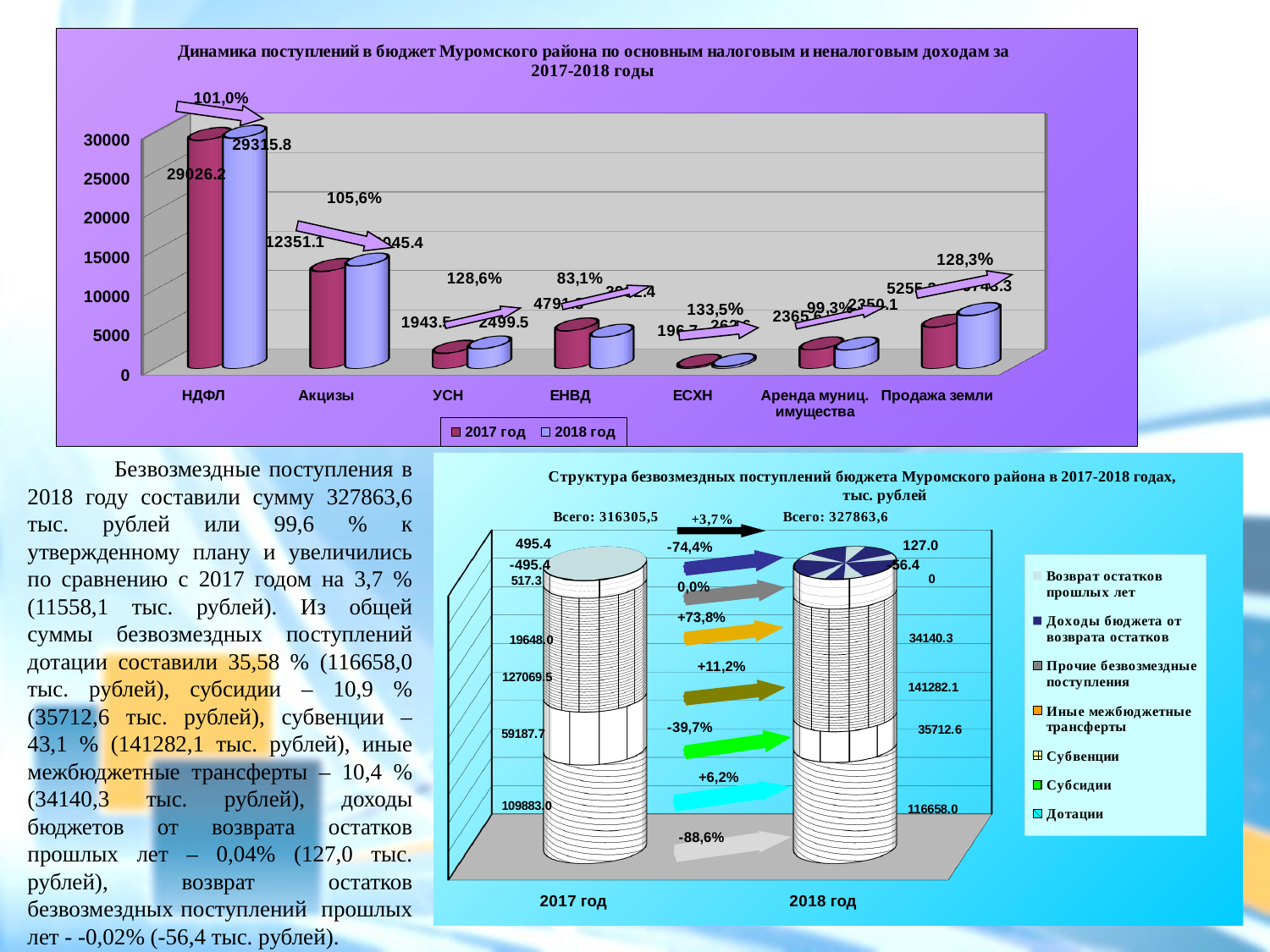
In the top chart (Динамика поступлений в бюджет Муромского района), by how much did НДФЛ increase from 2017 год to 2018 год? 289.6 In the bottom chart (Структура безвозмездных поступлений), what is the value for Дотации in 2018 год? 116658.0 In the top chart (Динамика поступлений в бюджет Муромского района), what is the value for УСН in 2018 год? 2499.5 In the top chart (Динамика поступлений в бюджет Муромского района), is the 2017 год value for Акцизы greater or less than 10000? greater In the bottom chart (Структура безвозмездных поступлений), how many entries does the legend list? 7 In the top chart (Динамика поступлений в бюджет Муромского района), what is the value for НДФЛ in 2017 год? 29026.2 In the top chart (Динамика поступлений в бюджет Муромского района), what is the value for НДФЛ in 2018 год? 29315.8 In the top chart (Динамика поступлений в бюджет Муромского района), how many categories are shown on the x axis? 7 In the bottom chart (Структура безвозмездных поступлений), what is the total (Всего) for 2018 год? 327863,6 In the top chart (Динамика поступлений в бюджет Муромского района), how many series does the legend list? 2 In the top chart (Динамика поступлений в бюджет Муромского района), which category has the highest values? НДФЛ In the top chart (Динамика поступлений в бюджет Муромского района), what percentage label is shown above the УСН bars? 128,6%